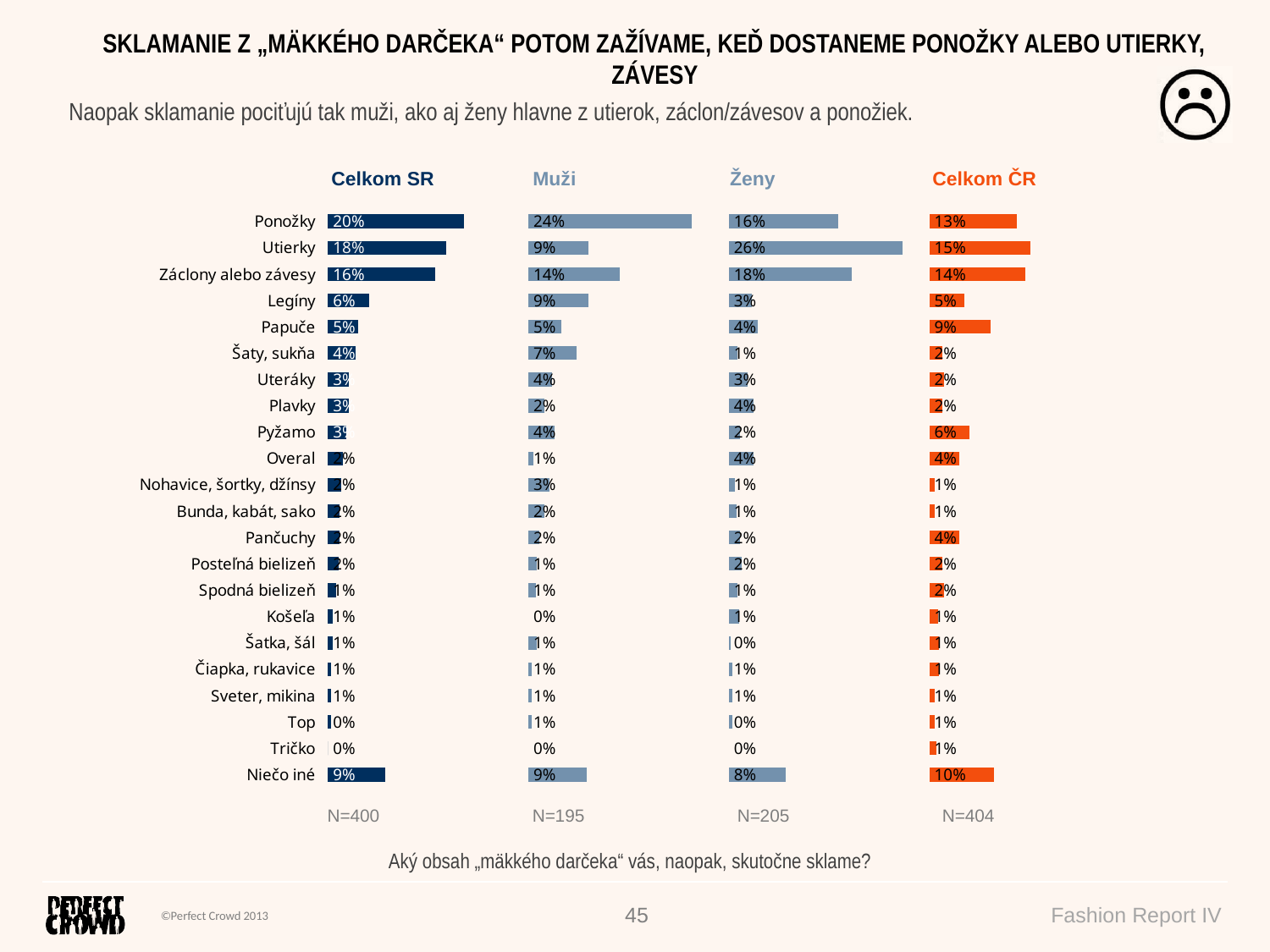
In the Muži chart, what is the value for Utierky? 9% In the Muži chart, which category has the highest value? Ponožky What kind of chart is used to show the Celkom SR values? Bar chart In the Celkom ČR chart, which is larger, the value for Utierky or the value for Ponožky? Utierky In the Ženy chart, which category has the highest value? Utierky In the Celkom ČR chart, what is the value for Papuče? 9% How many categories are listed in the Celkom SR chart? 22 In the Ženy chart, what is the difference between the values for Utierky and Ponožky? 10% In the Celkom SR chart, what is the value for Ponožky? 20% In the Muži chart, what is the difference between the values for Ponožky and Záclony alebo závesy? 10% In the Ženy chart, what is the value for Niečo iné? 8% What sample size (N) is shown under the Muži chart? N=195